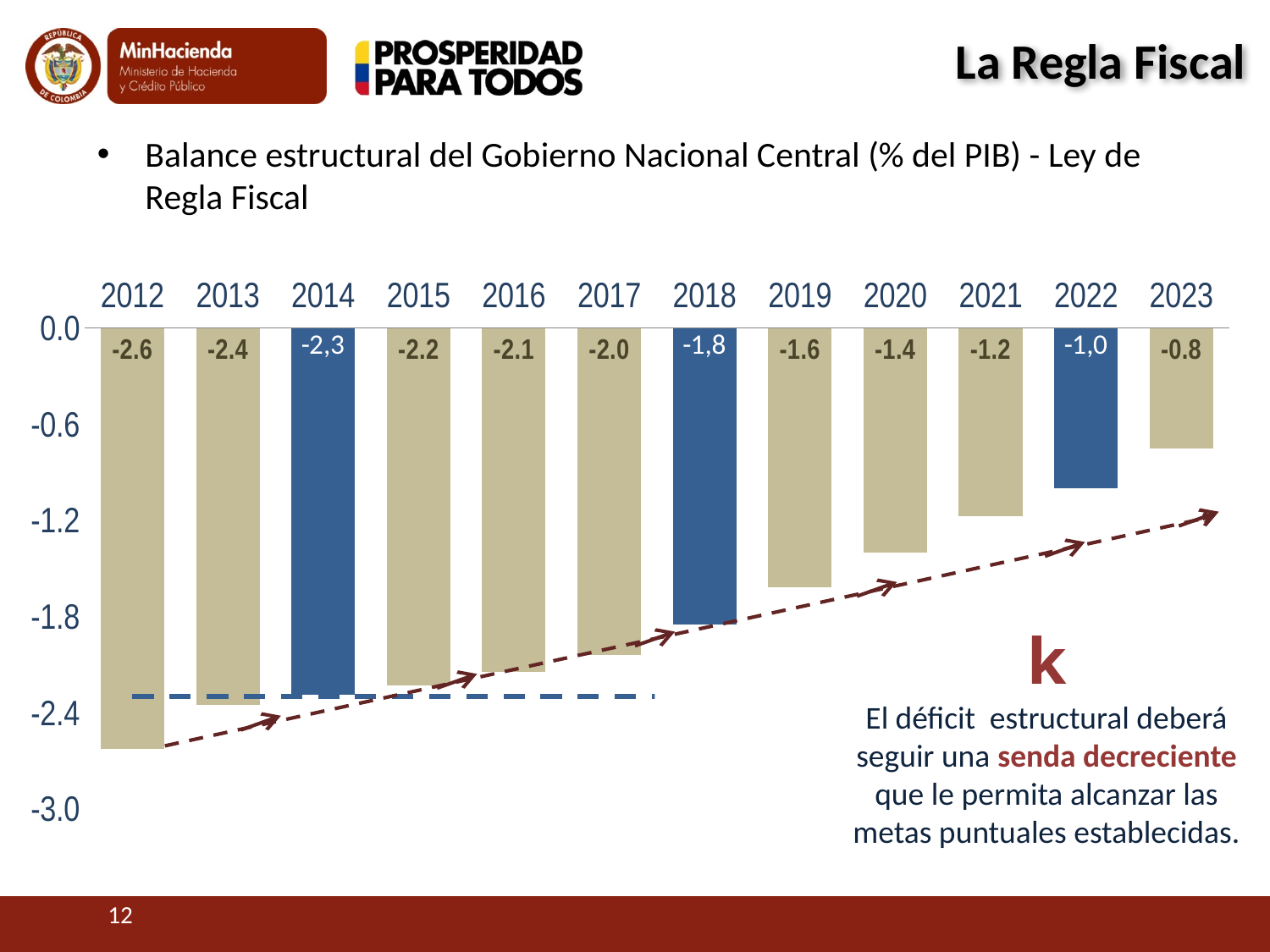
What kind of chart is shown on the slide? bar chart What is the difference between the values for 2012 and 2023? 1.8 Which year has the lowest (most negative) structural balance? 2012 Which years are shown with blue bars instead of beige bars? 2014, 2018 and 2022 What is the structural balance value shown for 2012? -2.6 What is the value shown for 2023? -0.8 How many years are plotted on the chart? 12 Do the values rise or fall from 2012 to 2023? rise What value is labelled on the bar for 2018? -1,8 What value is labelled on the bar for 2014? -2,3 Which is larger, the value for 2016 or the value for 2020? 2020 Which year has the highest (least negative) structural balance? 2023